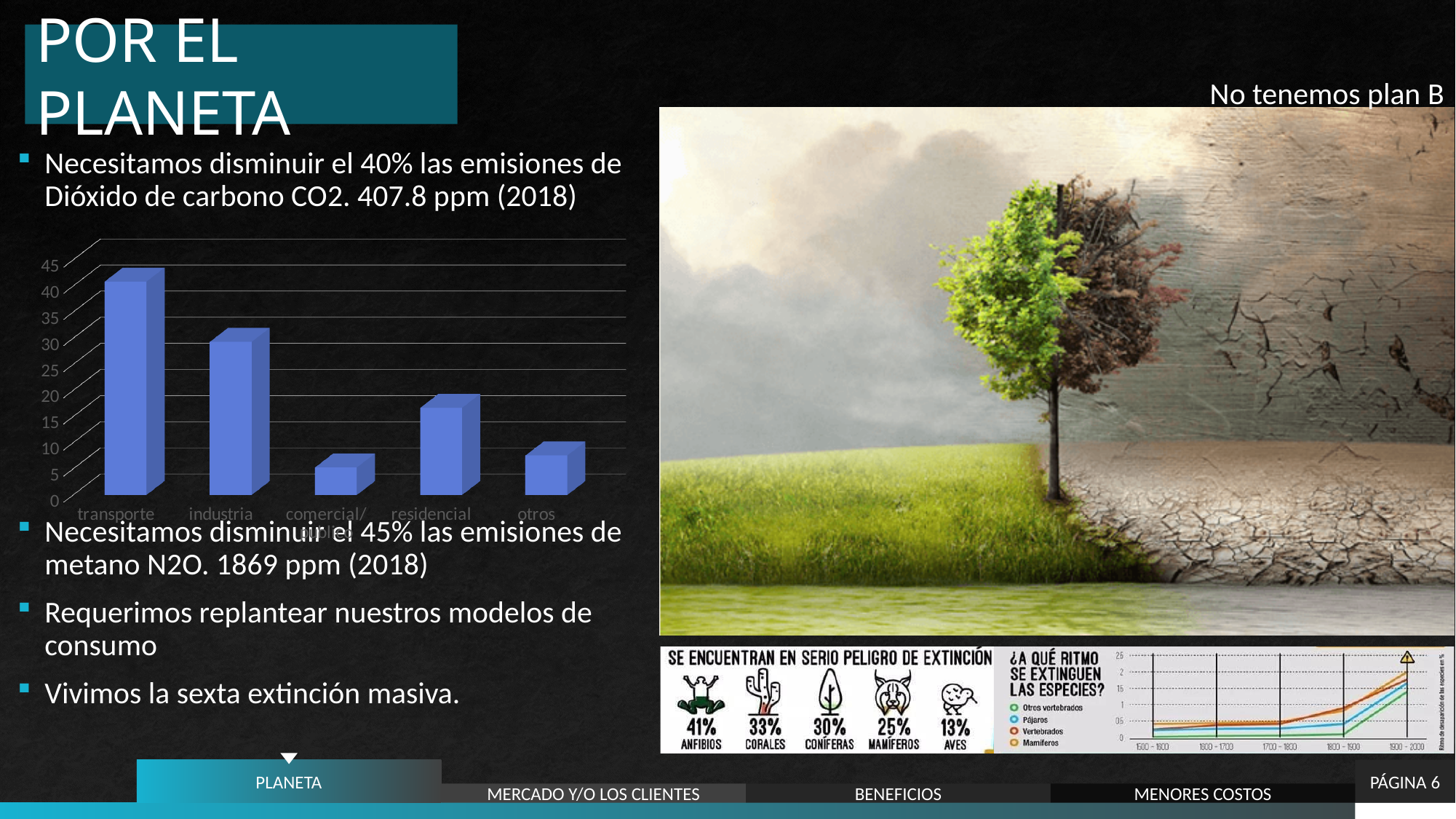
In the bar chart on the left, which is larger, industria or residencial? industria Which category has the lowest bar in the bar chart on the left? comercial/público In the bar chart on the left, is the value for residencial greater or less than 10? greater In the bar chart on the left, is the value for transporte greater or less than 35? greater What is the highest tick value shown on the vertical axis of the bar chart on the left? 45 In the bar chart on the left, which is larger, otros or comercial/público? otros In the bar chart on the left, is the value for industria greater or less than 25? greater Which category has the highest bar in the bar chart on the left? transporte What kind of chart is shown on the left of the slide? bar chart How many categories does the bar chart on the left show? 5